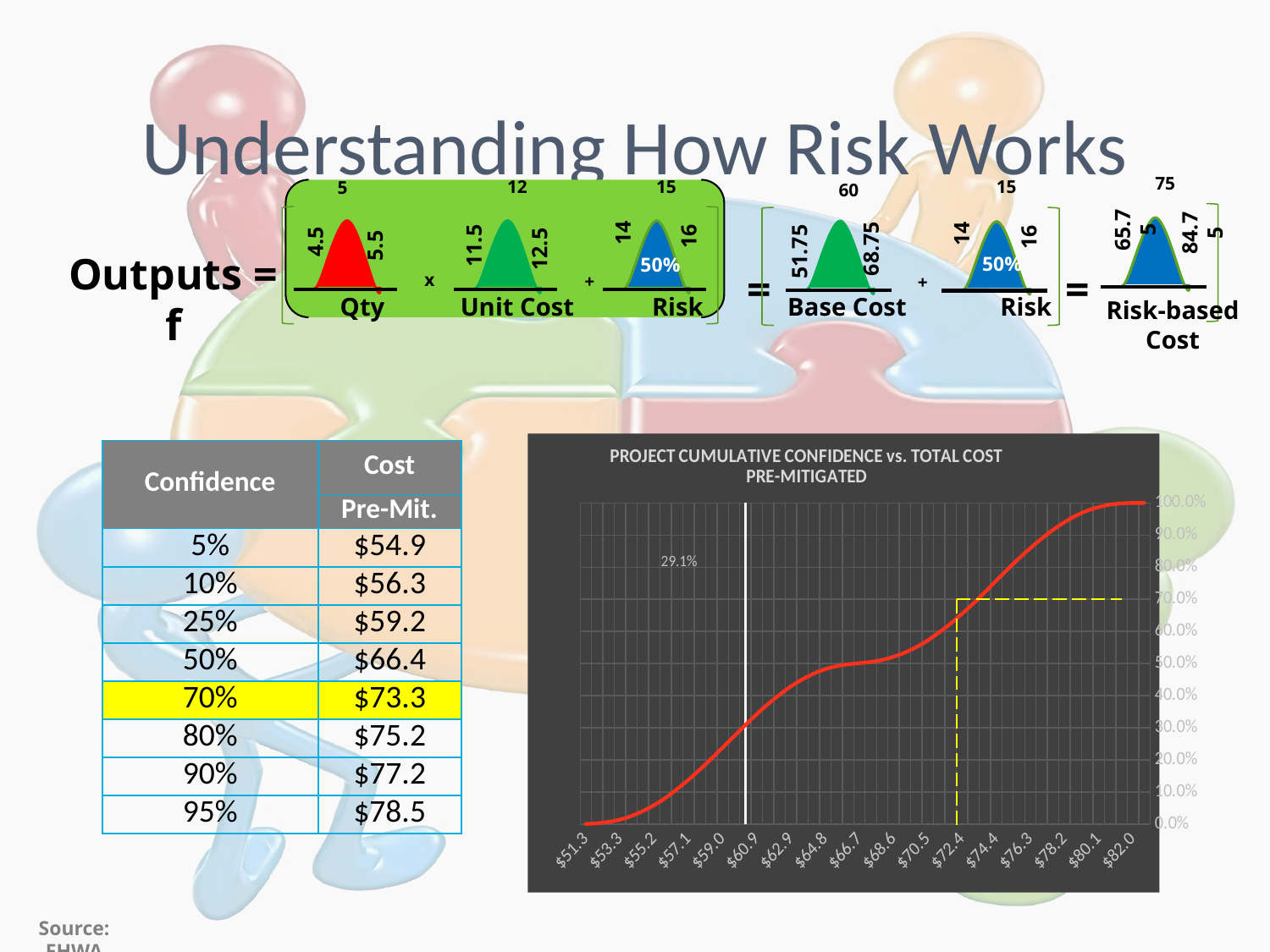
Does the plotted line rise or fall as total cost increases along the x axis? rises What is the title of the chart? PROJECT CUMULATIVE CONFIDENCE vs. TOTAL COST PRE-MITIGATED Is the cumulative confidence at $82.0 greater or less than 90.0%? greater What percentage value is printed as a data label next to the white vertical line on the chart? 29.1% What is the highest tick label shown on the y axis of the chart? 100.0% Which x-axis cost value is the first (leftmost) label on the chart? $51.3 How many cost values are labelled along the x axis of the chart? 17 Is the cumulative confidence at $57.1 greater or less than 20.0%? less What kind of chart is shown on the slide? line chart Is the cumulative confidence at $74.4 greater or less than 60.0%? greater